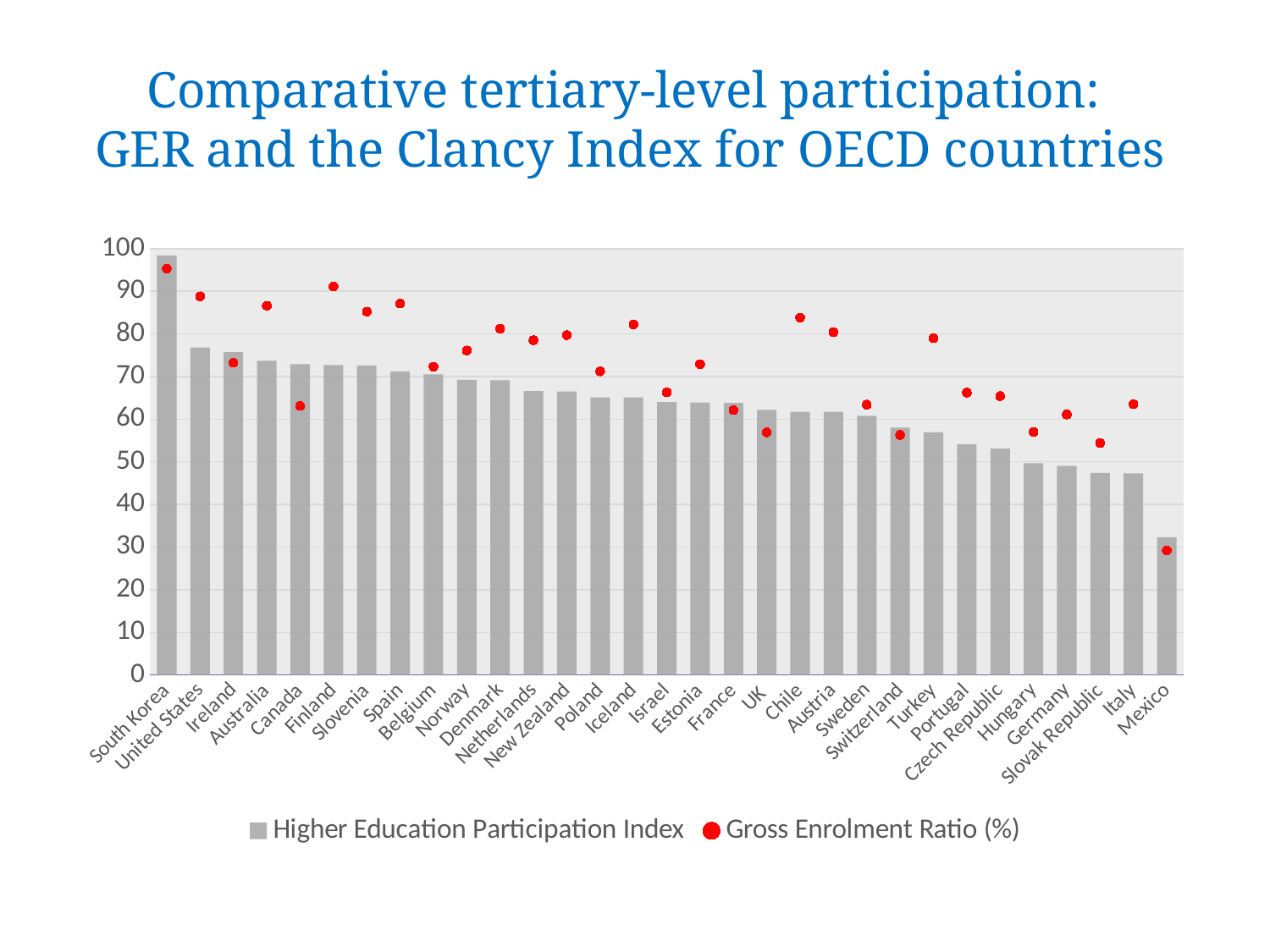
Is the Gross Enrolment Ratio (%) for Chile greater or less than 80? greater How many countries are shown on the x axis? 31 Which country has the lowest Gross Enrolment Ratio (%) point? Mexico Is the Gross Enrolment Ratio (%) for Canada greater or less than 70? less Which has the larger Gross Enrolment Ratio (%), Canada or Finland? Finland Which country has the lowest Higher Education Participation Index bar? Mexico Is the Higher Education Participation Index for South Korea greater or less than 90? greater Which country has the highest Higher Education Participation Index bar? South Korea What kind of chart is shown on the slide? A bar chart combined with a dot (scatter) series How many series does the legend list? 2 Do the Higher Education Participation Index bars rise or fall from left to right along the x axis? fall